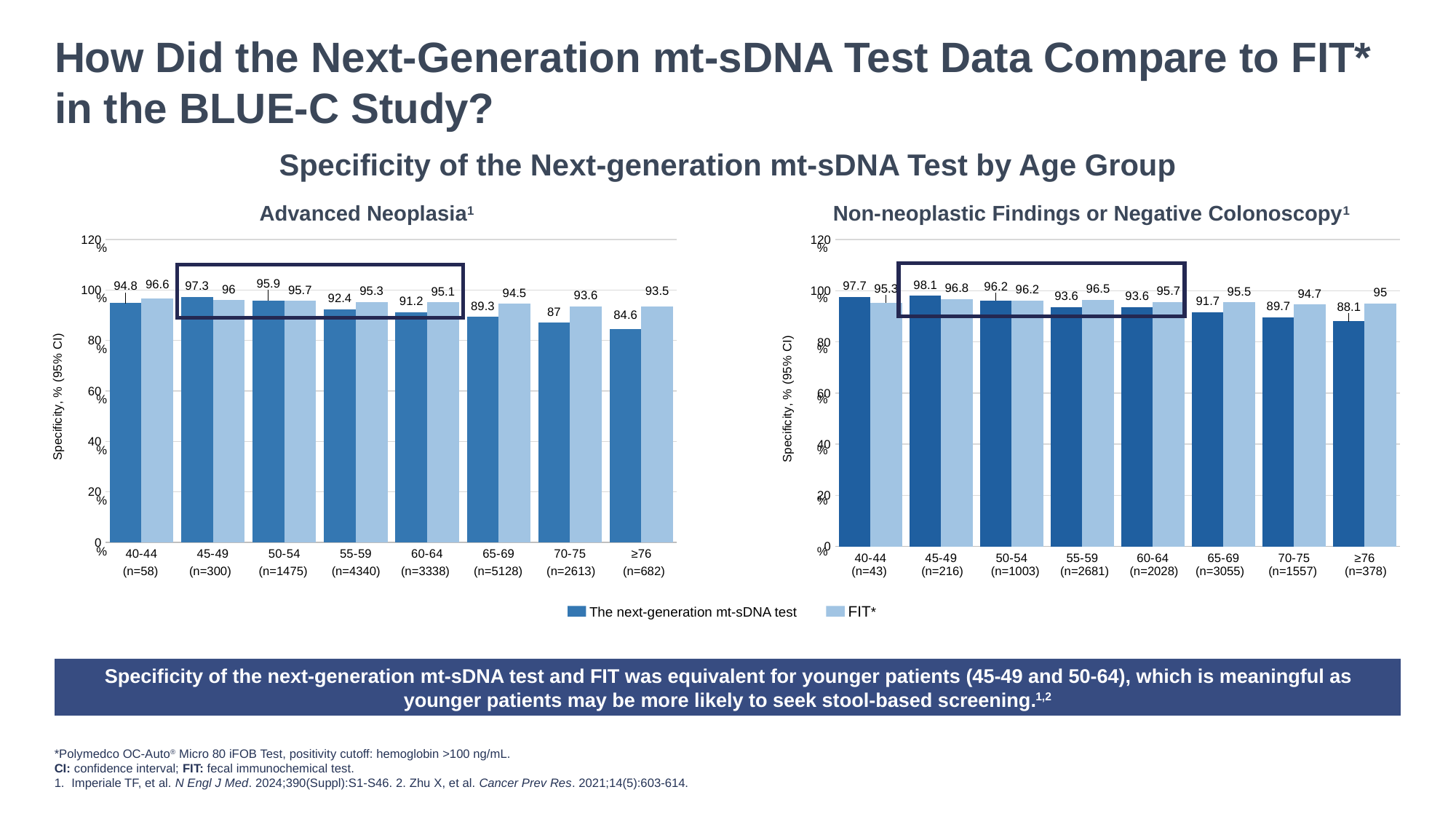
In the Advanced Neoplasia chart, what is the difference between the FIT* value and the next-generation mt-sDNA test value for the 70-75 age group? 6.6 In the Non-neoplastic Findings or Negative Colonoscopy chart, what is the next-generation mt-sDNA test value for the 40-44 age group? 97.7 How many age groups are shown on the x axis of the Advanced Neoplasia chart? 8 In the Non-neoplastic Findings or Negative Colonoscopy chart, which age group has the highest next-generation mt-sDNA test value? 45-49 In the Advanced Neoplasia chart, do the next-generation mt-sDNA test values rise or fall from the 45-49 age group to the ≥76 age group? Fall What kind of chart is the Non-neoplastic Findings or Negative Colonoscopy chart? Bar chart In the Advanced Neoplasia chart, what is the FIT* value for the ≥76 age group? 93.5 In the Non-neoplastic Findings or Negative Colonoscopy chart, what is the FIT* value for the 60-64 age group? 95.7 In the Advanced Neoplasia chart, which age group has the lowest next-generation mt-sDNA test value? ≥76 How many series does the legend list? 2 In the Non-neoplastic Findings or Negative Colonoscopy chart, which is larger for the ≥76 age group: the next-generation mt-sDNA test value or the FIT* value? FIT* In the Advanced Neoplasia chart, what is the specificity of the next-generation mt-sDNA test for the 45-49 age group? 97.3